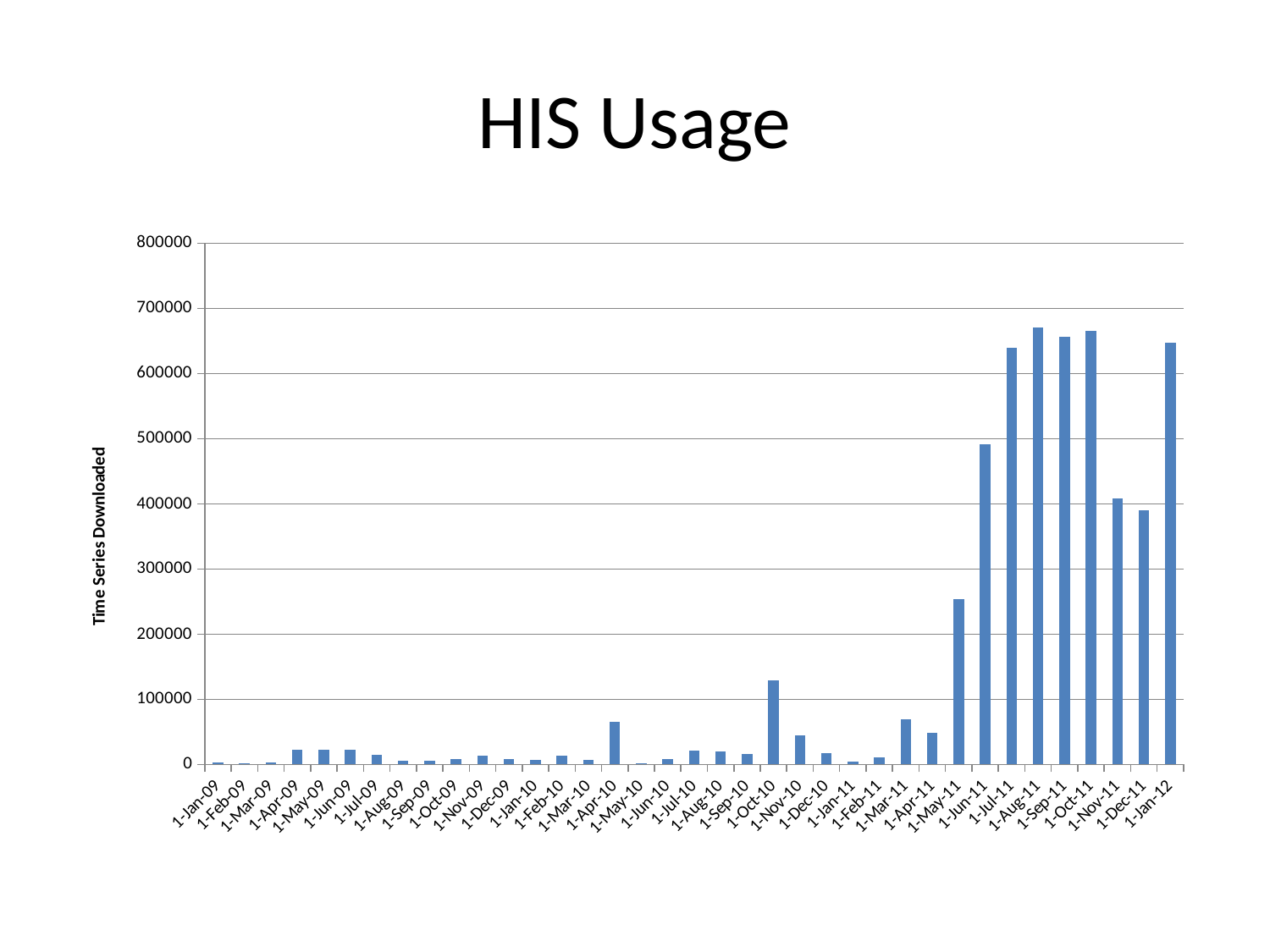
How many monthly categories are plotted along the x axis? 37 Is the value for 1-Apr-10 greater or less than 100000? less Overall, do the values rise or fall from 2009 to 2011 along the x axis? Rise Is the value for 1-Dec-11 greater or less than 400000? less Is the value for 1-Jul-11 greater or less than 600000? greater What kind of chart is shown on the slide? Bar chart Which has the larger value, 1-Oct-10 or 1-Nov-10? 1-Oct-10 Which has the larger value, 1-May-11 or 1-Jun-11? 1-Jun-11 What is the label on the vertical axis of the chart? Time Series Downloaded What is the title of the chart? HIS Usage